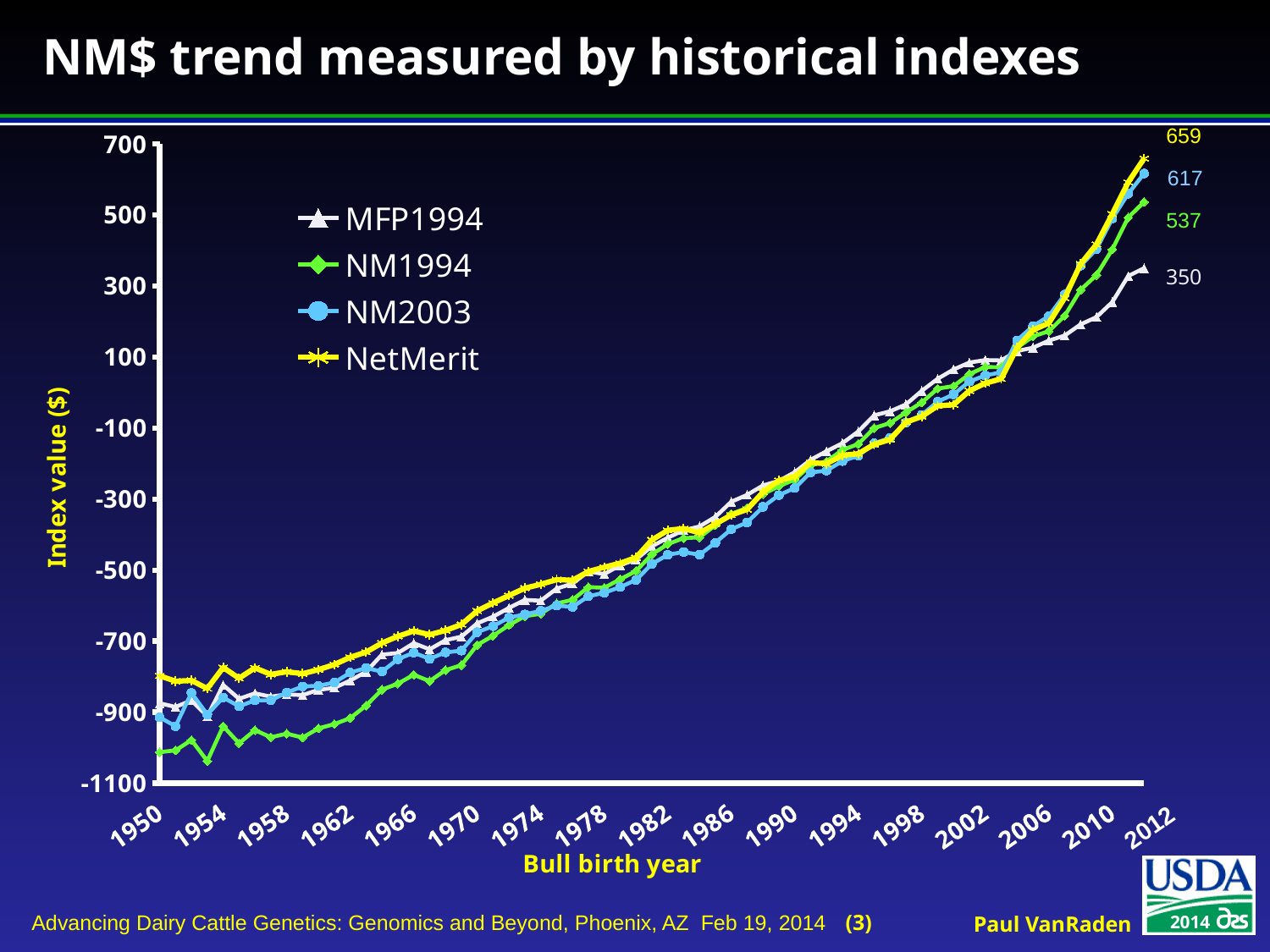
What is the difference between the 2012 values of NetMerit and MFP1994? 309 How many series does the legend list? 4 Which series has the lowest value in 2012? MFP1994 Do the index values generally rise or fall as bull birth year increases from 1950 to 2012? Rise What is the final value shown for the NetMerit series in 2012? 659 Which series has the larger 2012 value, NM2003 or NM1994? NM2003 Which series has the highest value in 2012? NetMerit What is the final value shown for the NM2003 series in 2012? 617 What kind of chart is shown on the slide? Line chart What is the final value shown for the NM1994 series in 2012? 537 What is the final value shown for the MFP1994 series in 2012? 350 Is the value for NM1994 in 1950 greater or less than -900? less